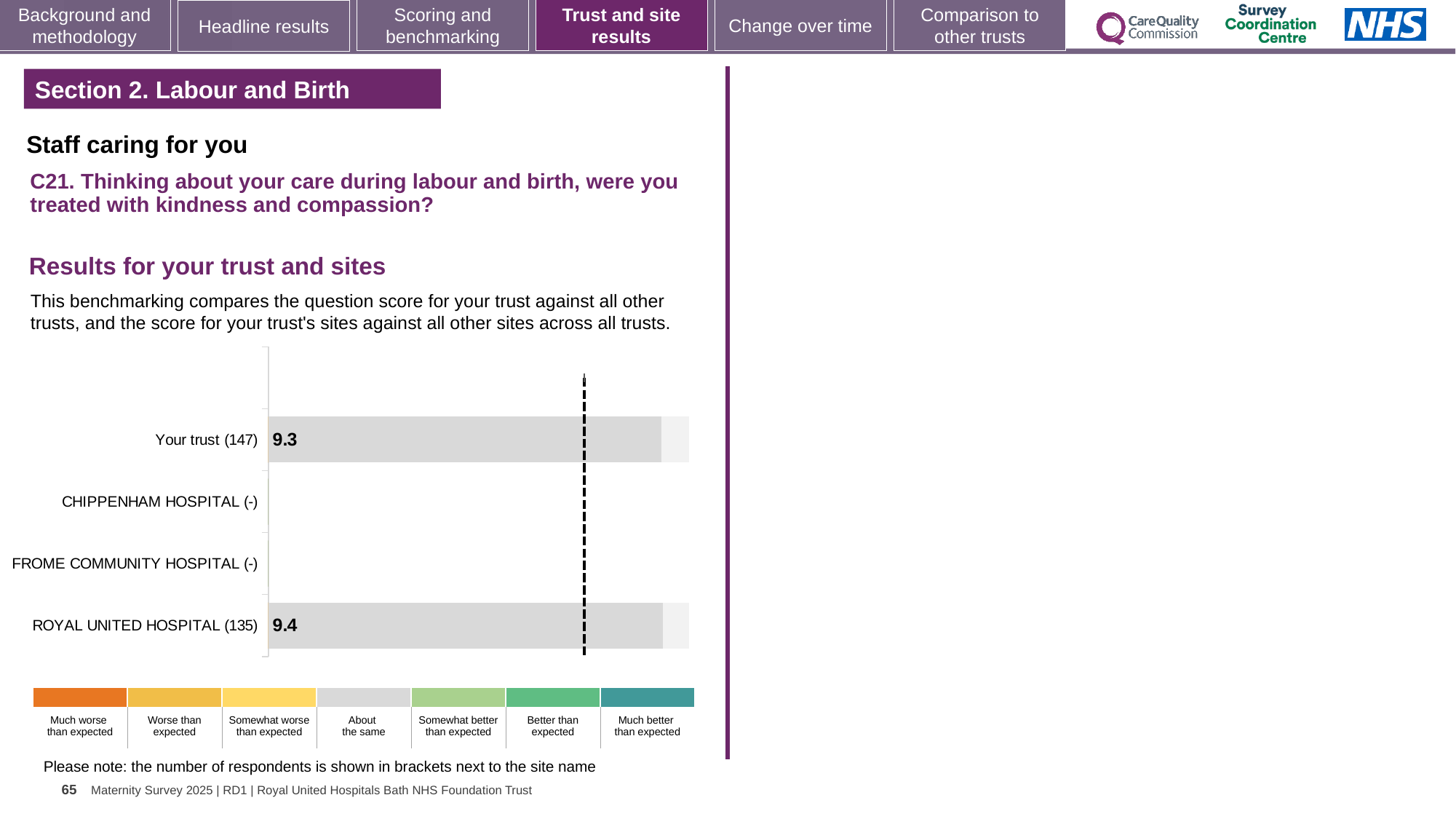
What is the difference between the score for ROYAL UNITED HOSPITAL and the score for Your trust? 0.1 What is the score for Your trust? 9.3 Which category on the chart has the highest plotted score? ROYAL UNITED HOSPITAL How many categories are listed on the chart's vertical axis? 4 Which two sites on the chart have no bar plotted? CHIPPENHAM HOSPITAL and FROME COMMUNITY HOSPITAL Which of the plotted bars has the higher score, Your trust or ROYAL UNITED HOSPITAL? ROYAL UNITED HOSPITAL What kind of chart is shown on the slide? Bar chart What is the score for ROYAL UNITED HOSPITAL? 9.4 How many categories does the colour key below the chart list? 7 How many respondents are shown in brackets for ROYAL UNITED HOSPITAL? 135 How many respondents are shown in brackets for Your trust? 147